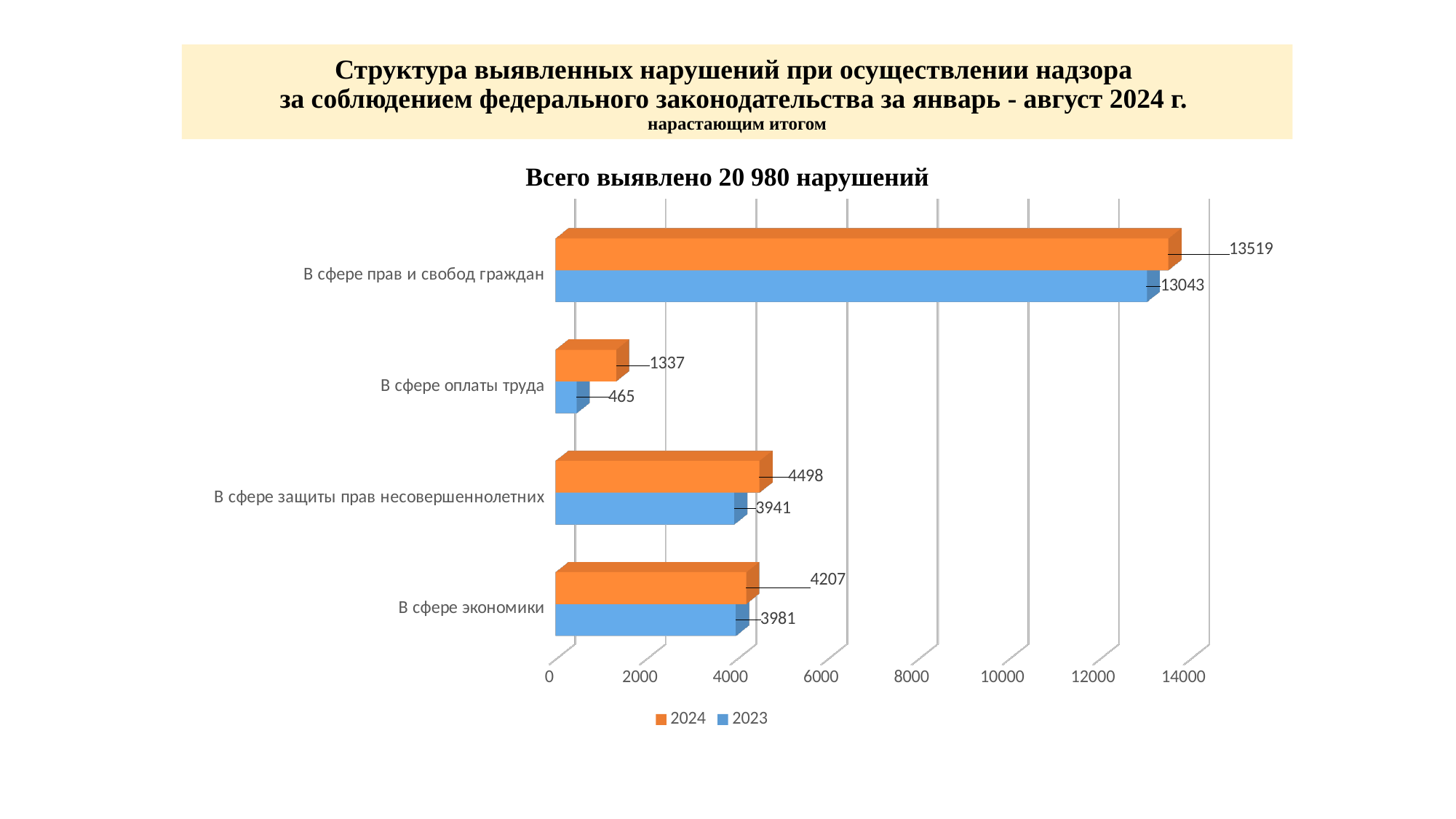
What is the 2024 value for «В сфере прав и свобод граждан»? 13519 Which category has the highest 2024 value? В сфере прав и свобод граждан How many series does the legend list? 2 What is the 2024 value for «В сфере защиты прав несовершеннолетних»? 4498 What is the 2023 value for «В сфере экономики»? 3981 What kind of chart is shown on the slide? Bar chart What is the 2023 value for «В сфере оплаты труда»? 465 What is the difference between the 2024 and 2023 values for «В сфере оплаты труда»? 872 Which is larger for «В сфере экономики»: the 2024 value or the 2023 value? 2024 How many categories are shown on the chart? 4 What is the difference between the 2024 and 2023 values for «В сфере прав и свобод граждан»? 476 Which category has the lowest 2023 value? В сфере оплаты труда